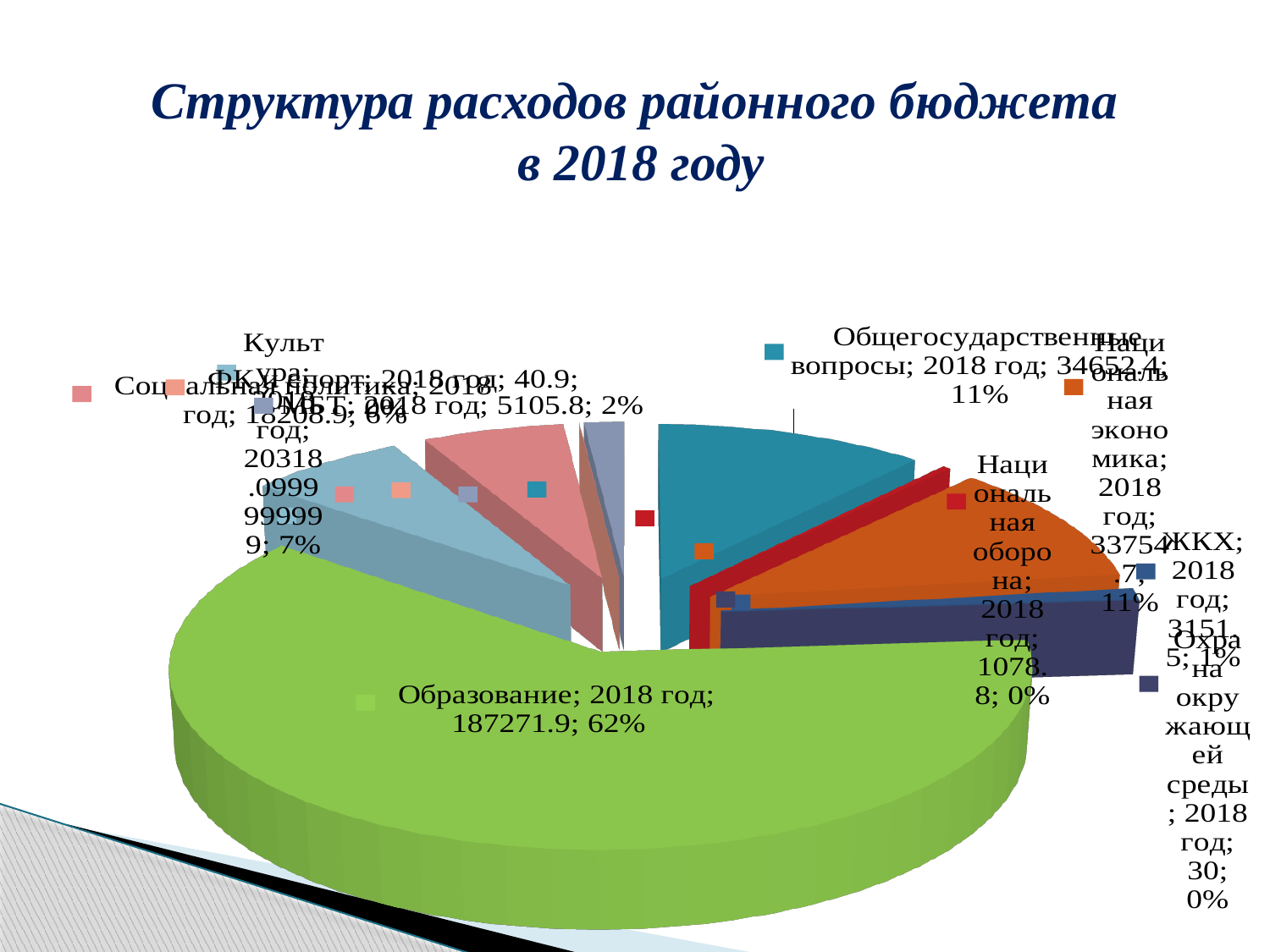
What is the value shown for Образование? 187271.9 What is the difference between the values for Общегосударственные вопросы and Национальная экономика? 897.7 What is the value shown for Охрана окружающей среды? 30 What share of the pie does Национальная экономика account for? 11% What is the value shown for Национальная оборона? 1078.8 What share of the pie does Образование account for? 62% What is the value shown for Общегосударственные вопросы? 34652.4 Which is larger, the value for Общегосударственные вопросы or the value for Национальная экономика? Общегосударственные вопросы Which category has the largest slice of the pie? Образование What is the title of the chart on the slide? Структура расходов районного бюджета в 2018 году What kind of chart is shown on the slide? Pie chart What is the value shown for ЖКХ? 3151.5